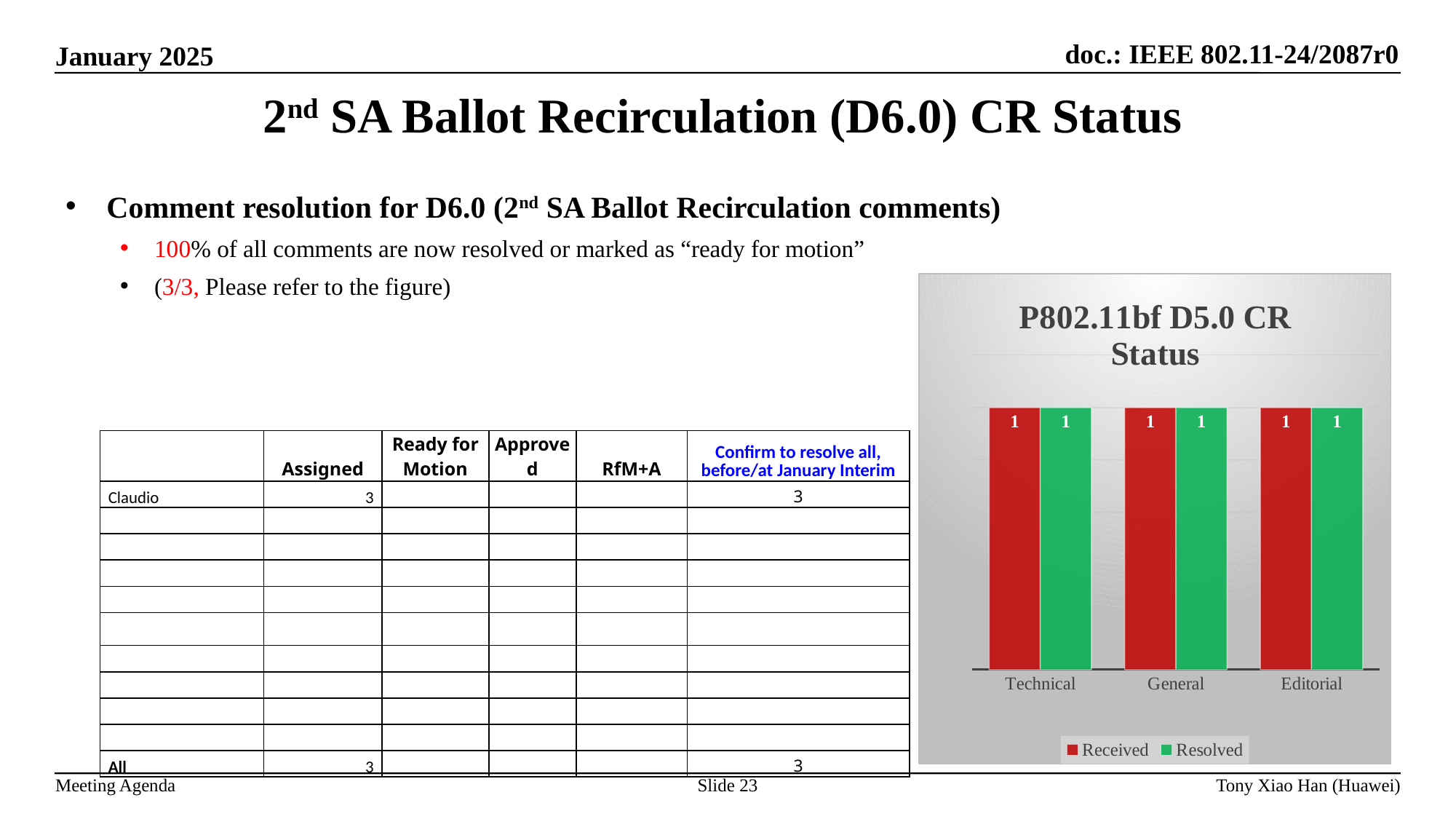
What kind of chart is shown on the slide? bar chart What is the Received value for Technical in the chart? 1 What is the Resolved value for Editorial in the chart? 1 What is the difference between the Received and Resolved values for Technical in the chart? 0 What is the Received value for Editorial in the chart? 1 Which colour represents the Resolved series in the chart? green How many categories are shown on the x axis of the chart? 3 What is the title of the chart on the slide? P802.11bf D5.0 CR Status What is the Resolved value for General in the chart? 1 What are the names of the series listed in the chart's legend? Received, Resolved How many series does the chart's legend list? 2